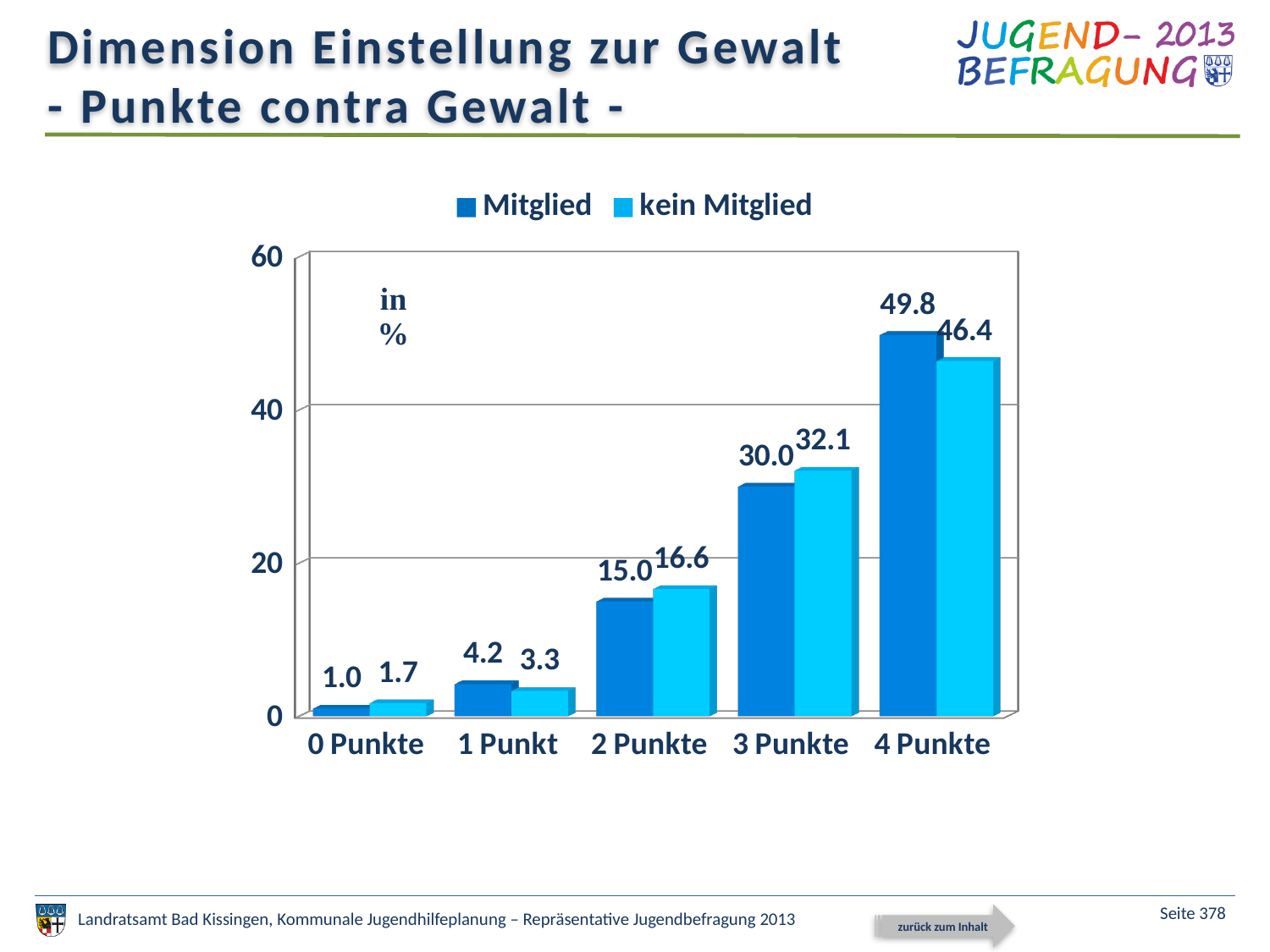
How many categories are shown on the x axis? 5 What is the value for Mitglied at 1 Punkt? 4.2 What kind of chart is shown on the slide? bar chart What is the difference between Mitglied and kein Mitglied at 4 Punkte? 3.4 What is the difference between kein Mitglied and Mitglied at 3 Punkte? 2.1 Which category has the lowest value for Mitglied? 0 Punkte What is the value for Mitglied at 4 Punkte? 49.8 What is the value for kein Mitglied at 2 Punkte? 16.6 How many series does the legend list? 2 Which category has the highest value for kein Mitglied? 4 Punkte Do the values for Mitglied rise or fall from 0 Punkte to 4 Punkte? rise At 1 Punkt, which series has the larger value, Mitglied or kein Mitglied? Mitglied